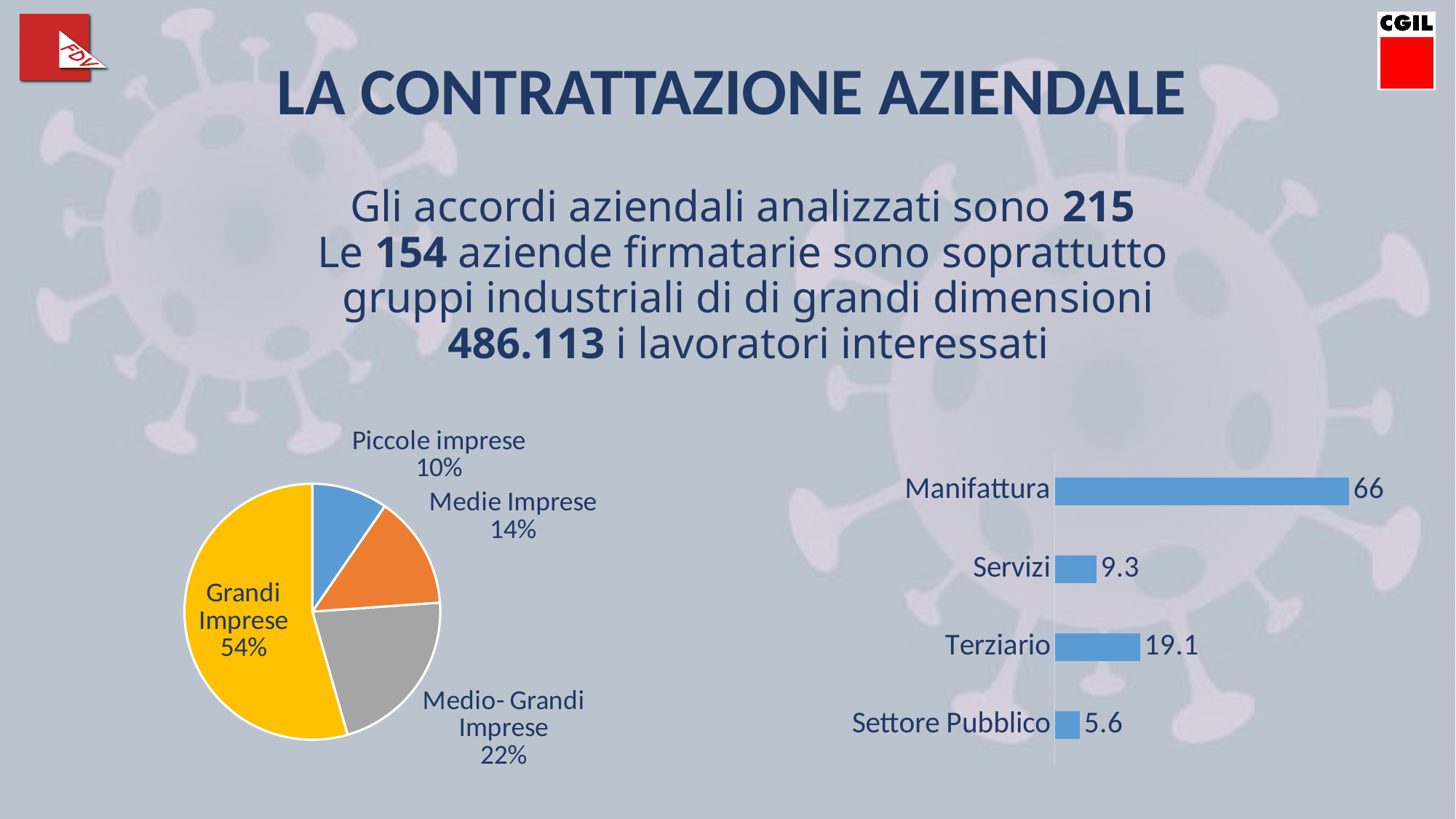
In the pie chart on the left, how many slices are there? 4 In the bar chart on the right, what is the value for Manifattura? 66 In the pie chart on the left, what is the difference between the shares of Medio- Grandi Imprese and Piccole imprese? 12% In the bar chart on the right, what is the difference between Manifattura and Terziario? 46.9 In the pie chart on the left, what share is shown for Medie Imprese? 14% In the pie chart on the left, what share is shown for Grandi Imprese? 54% In the bar chart on the right, what is the value for Settore Pubblico? 5.6 What kind of chart is shown on the right of the slide? Bar chart In the bar chart on the right, which is larger, Servizi or Terziario? Terziario In the pie chart on the left, which category has the largest slice? Grandi Imprese In the pie chart on the left, which category has the smallest slice? Piccole imprese In the bar chart on the right, which category has the lowest value? Settore Pubblico